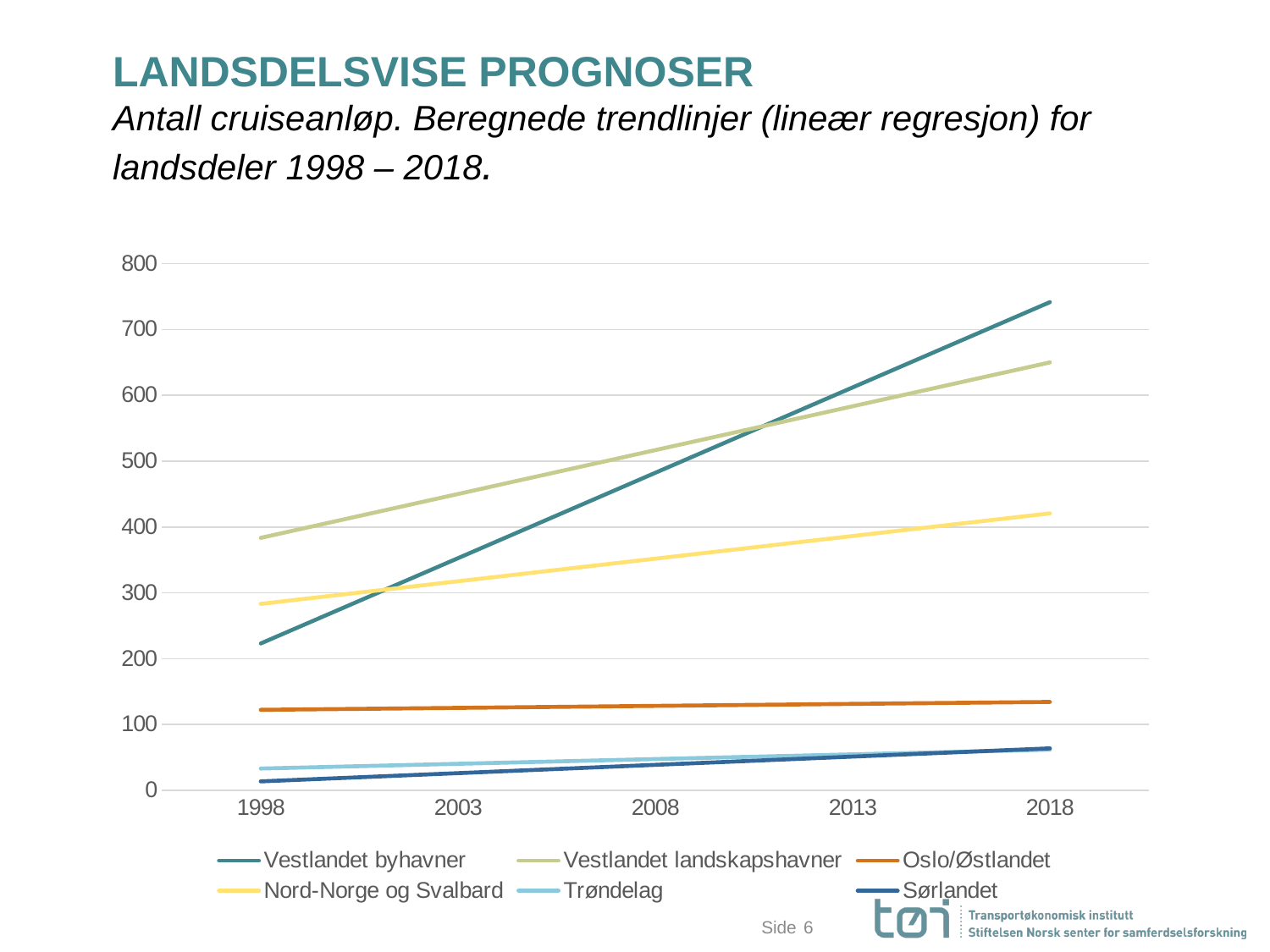
Is the value for Vestlandet landskapshavner in 1998 greater or less than 300? greater Which series has the highest value in 1998? Vestlandet landskapshavner In 2003, which is larger: Vestlandet landskapshavner or Vestlandet byhavner? Vestlandet landskapshavner Does the Vestlandet byhavner line rise or fall from 1998 to 2018? rise Is the value for Oslo/Østlandet in 1998 greater or less than 200? less What is the title of the slide above the chart? LANDSDELSVISE PROGNOSER Which series has the highest value in 2018? Vestlandet byhavner Is the value for Vestlandet byhavner in 2018 greater or less than 700? greater How many year labels are shown on the x axis? 5 Which series has the lowest value in 1998? Sørlandet What kind of chart is shown on the slide? line chart How many series does the legend list? 6